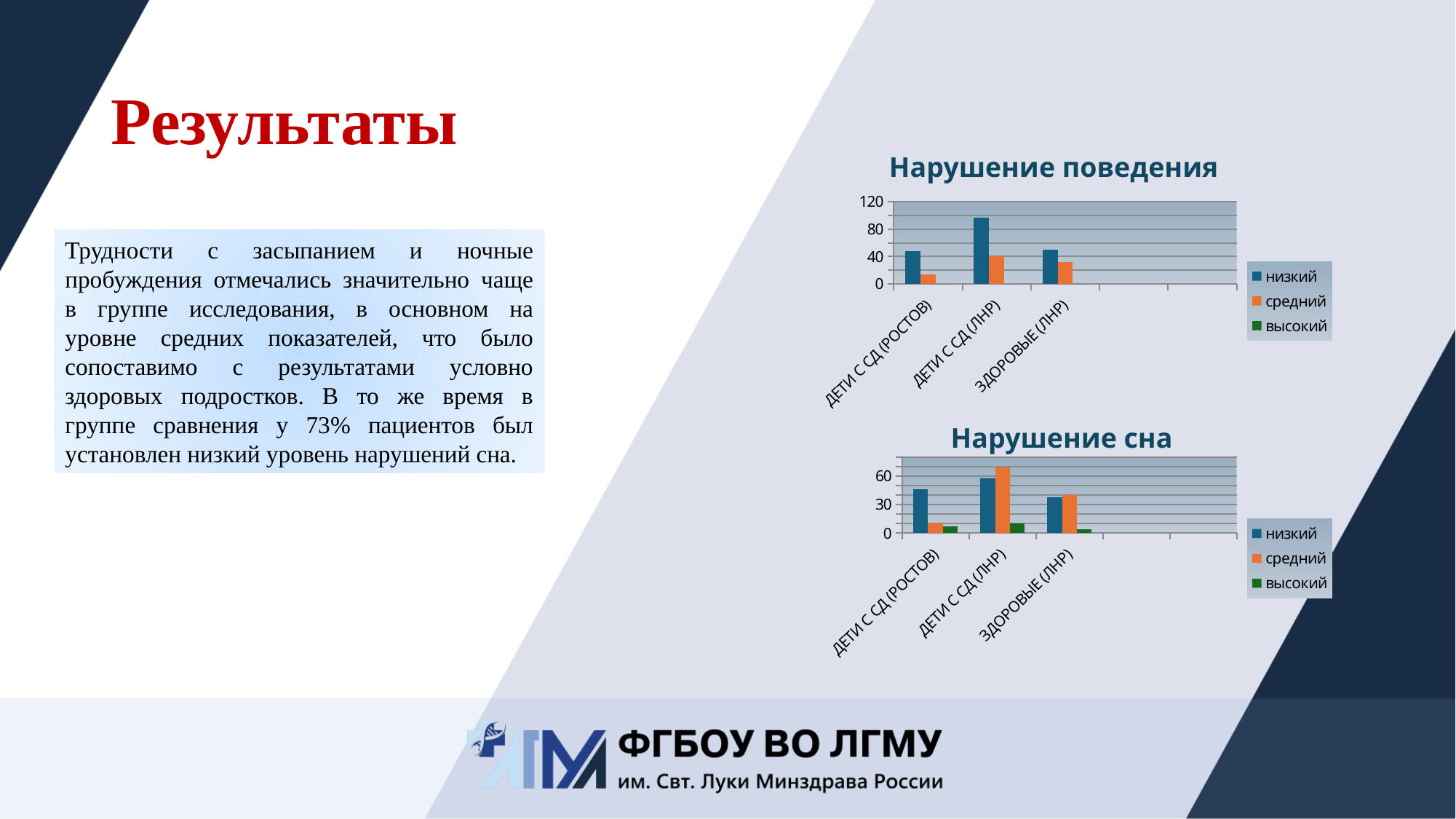
In the "Нарушение поведения" chart, for ДЕТИ С СД (ЛНР), which is larger: "низкий" or "средний"? низкий In the "Нарушение сна" chart, which category has the highest value for the series "средний"? ДЕТИ С СД (ЛНР) What kind of chart is the top chart titled "Нарушение поведения"? bar chart What is the title of the bottom chart on the slide? Нарушение сна In the "Нарушение поведения" chart, is the value of "низкий" for ДЕТИ С СД (ЛНР) greater or less than 80? greater In the "Нарушение сна" chart, for ДЕТИ С СД (РОСТОВ), which is larger: "низкий" or "средний"? низкий In the "Нарушение сна" chart, is the value of "средний" for ДЕТИ С СД (ЛНР) greater or less than 60? greater In the "Нарушение поведения" chart, is the value of "средний" for ДЕТИ С СД (РОСТОВ) greater or less than 40? less How many categories are shown on the x axis of the "Нарушение поведения" chart? 3 How many series does the legend of the "Нарушение сна" chart list? 3 In the "Нарушение поведения" chart, which category has the highest value for the series "низкий"? ДЕТИ С СД (ЛНР) In the "Нарушение сна" chart, which category has the lowest value for the series "высокий"? ЗДОРОВЫЕ (ЛНР)